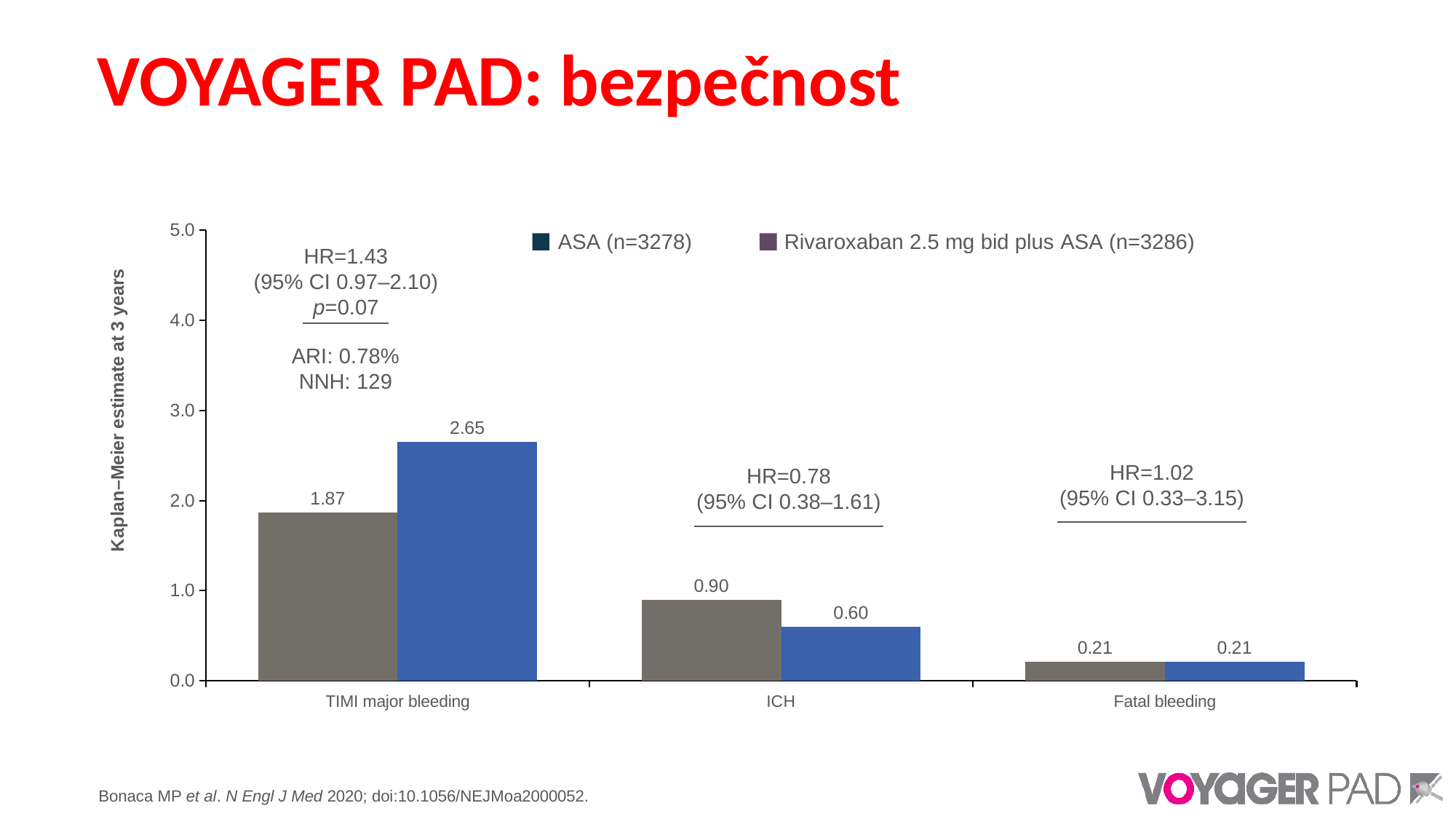
What is the difference between the two bars for ICH? 0.30 What is the value of the right (second) bar for TIMI major bleeding? 2.65 What is the value of the left (first) bar for ICH? 0.90 How many categories are shown on the x axis? 3 What is the label of the y axis? Kaplan–Meier estimate at 3 years What is the value of the bars for Fatal bleeding? 0.21 What kind of chart is shown on the slide? bar chart What is the difference between the two bars for TIMI major bleeding? 0.78 How many series does the legend list? 2 What is the value of the left (first) bar for TIMI major bleeding? 1.87 Which category has the highest bar in the chart? TIMI major bleeding What is the value of the right (second) bar for ICH? 0.60